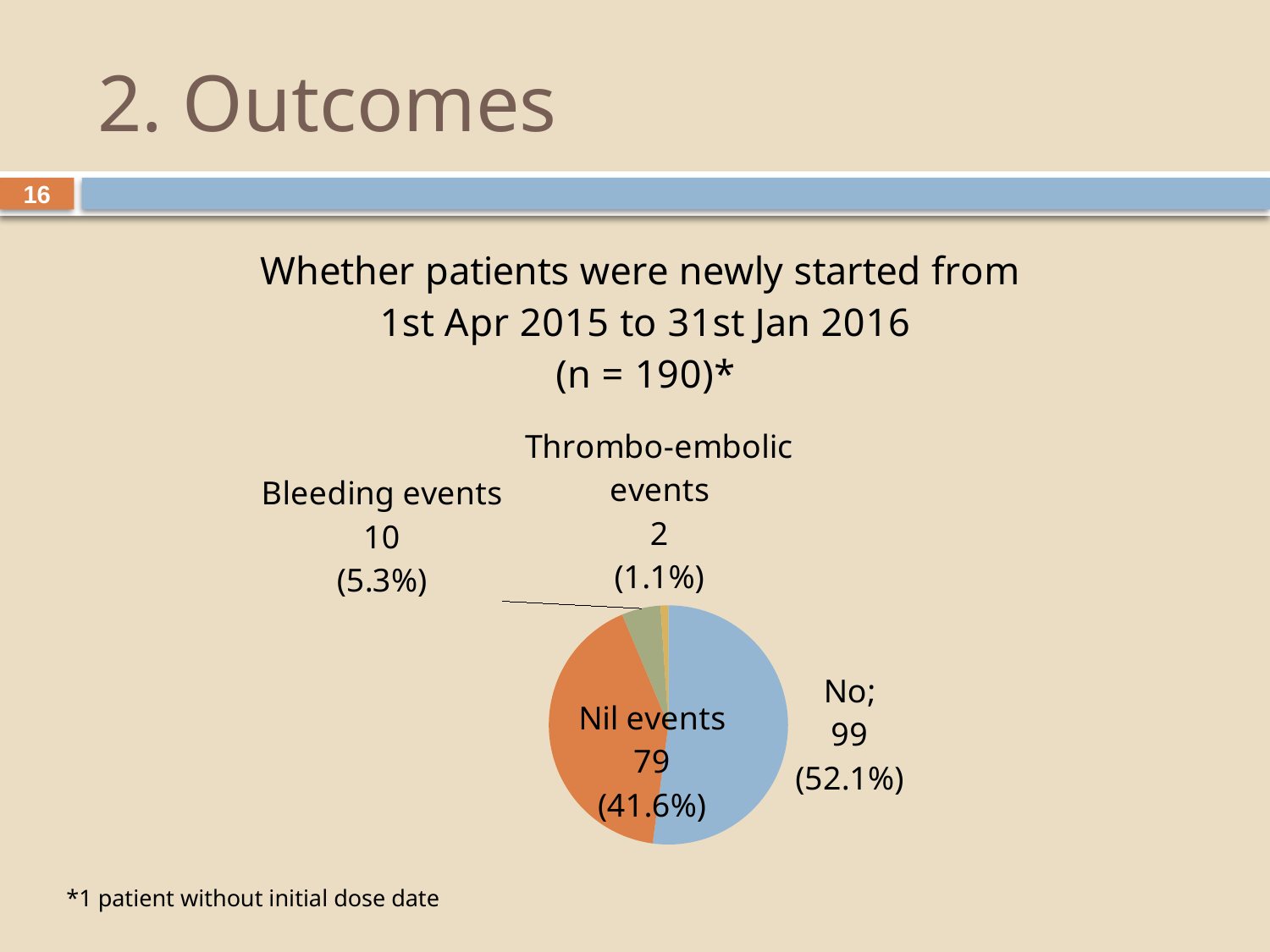
What is the n value stated in the chart title? 190 What kind of chart is shown on the slide? Pie chart What share of the pie does 'Nil events' represent? 41.6% What is the value for the 'No' slice? 99 Which category has the largest slice? No How many slices does the pie chart have? 4 What is the value for 'Thrombo-embolic events'? 2 Which category has the smallest slice? Thrombo-embolic events What is the value for 'Nil events'? 79 What is the difference between the 'No' value and the 'Nil events' value? 20 What share of the pie does 'Bleeding events' represent? 5.3% What is the value for 'Bleeding events'? 10